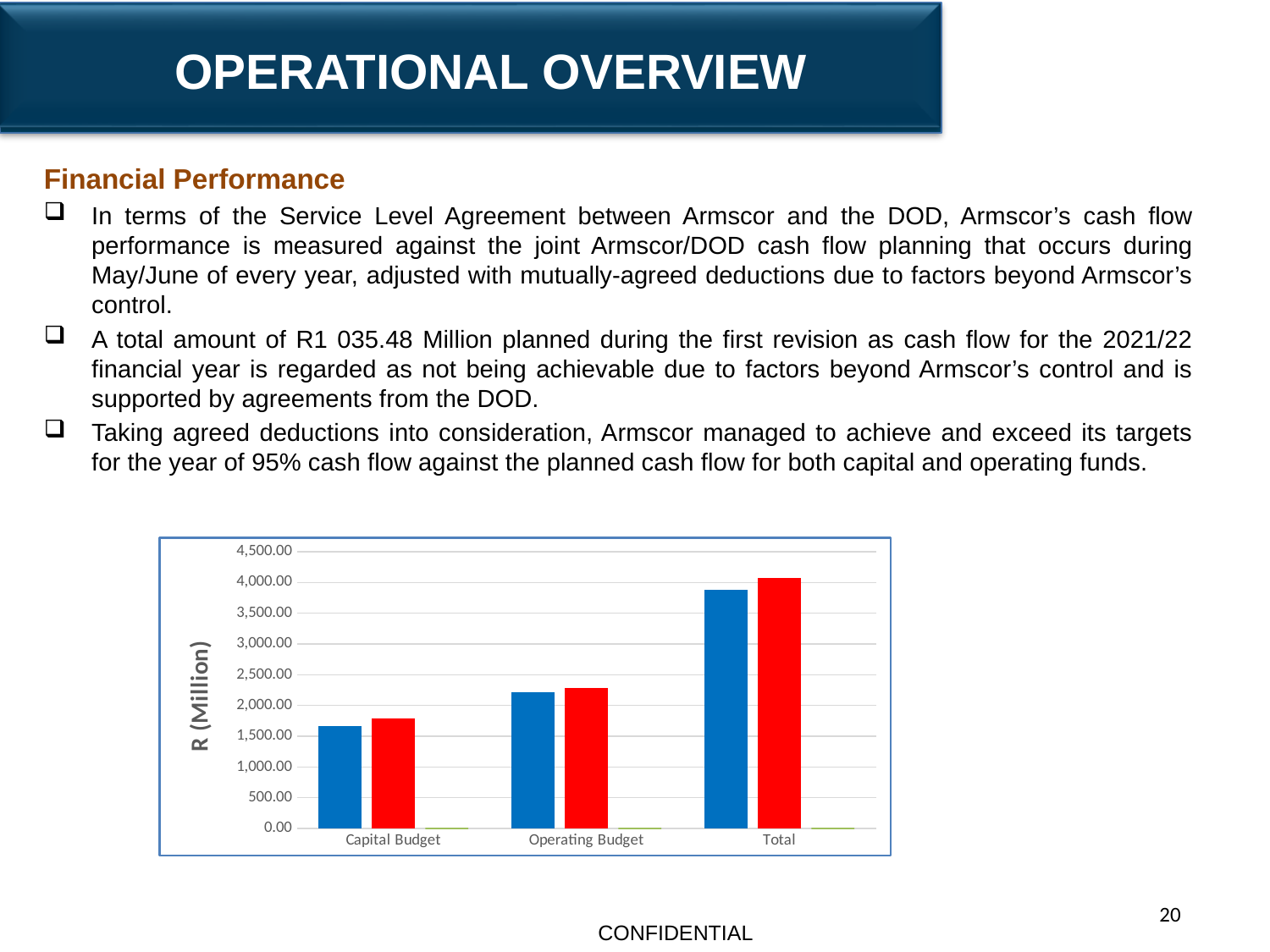
What kind of chart is shown on the slide? bar chart Is the value of the red bar for Capital Budget greater or less than 2,000.00? less For the Total category, which bar is taller, the blue bar or the red bar? the red bar Do the bar values rise or fall moving from Capital Budget to Total along the x axis? rise What is the highest value shown on the vertical axis of the chart? 4,500.00 Which category has the tallest bars in the chart? Total Is the value of the blue bar for Total greater or less than 4,000.00? less Is the value of the blue bar for Capital Budget greater or less than 1,500.00? greater How many categories are shown on the x axis of the chart? 3 What is the label of the vertical axis of the chart? R (Million) Which category has the shortest bars in the chart? Capital Budget